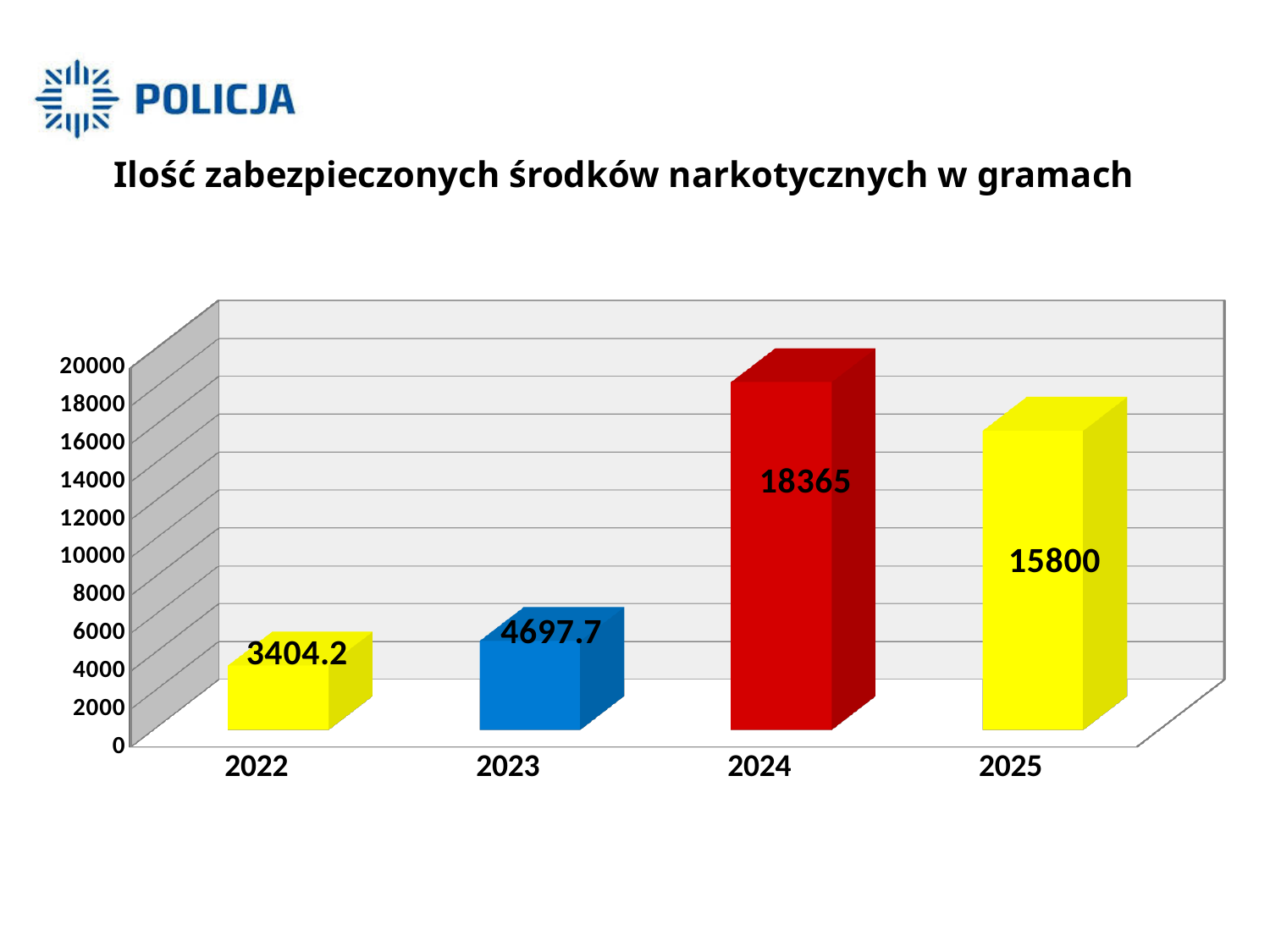
Which year has the highest value? 2024 What is the title of the chart? Ilość zabezpieczonych środków narkotycznych w gramach Which is larger, the value for 2023 or the value for 2025? 2025 What is the value for 2025? 15800 What is the value for 2024? 18365 What kind of chart is shown on the slide? bar chart How many years are shown on the x axis? 4 What is the value for 2022? 3404.2 Which year has the lowest value? 2022 What is the value for 2023? 4697.7 What is the difference between the values for 2024 and 2025? 2565 What is the difference between the values for 2023 and 2022? 1293.5